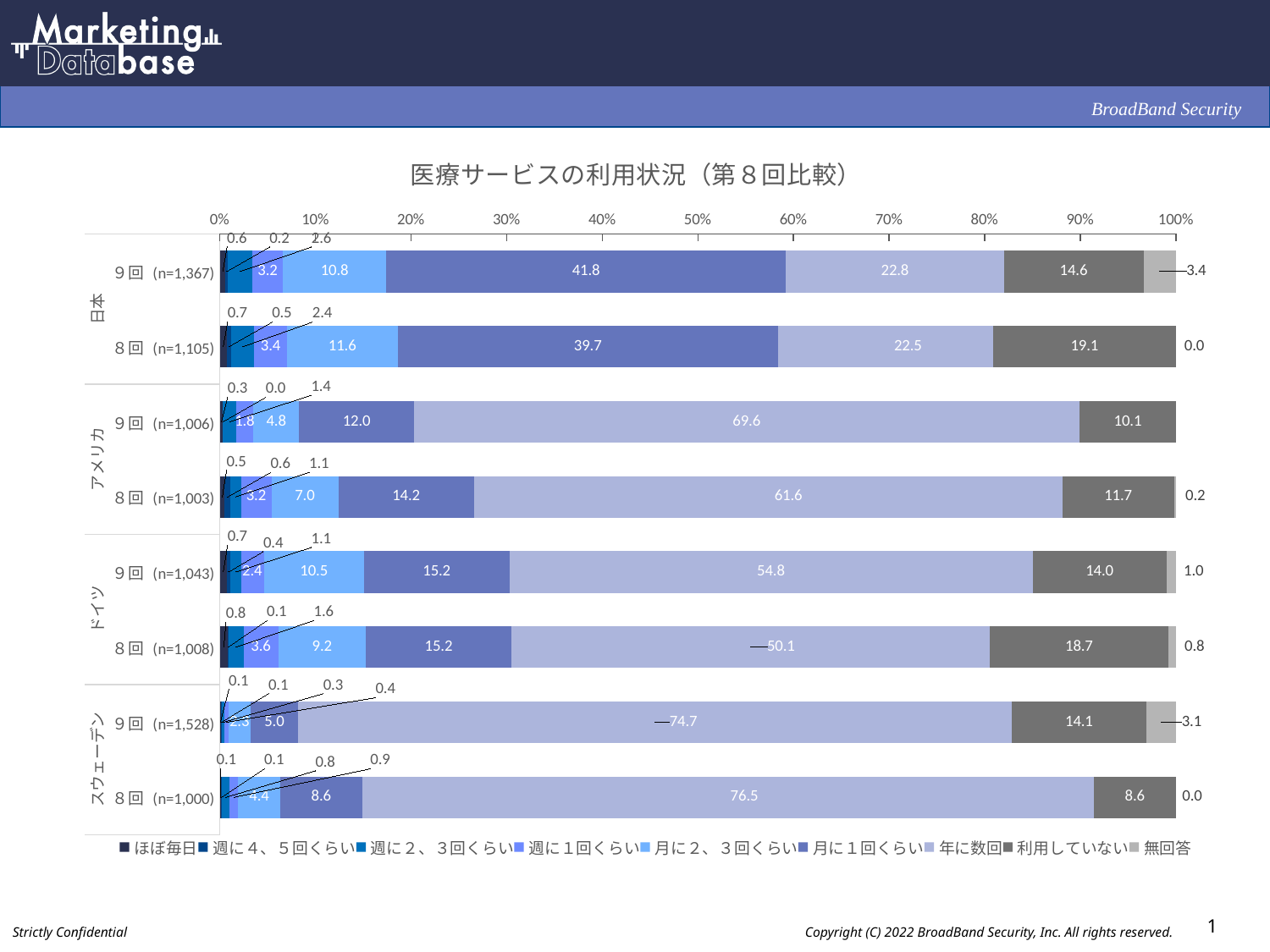
What is the value of 年に数回 for スウェーデン 8回 (n=1,000)? 76.5 What is the difference between the 年に数回 values for アメリカ 9回 (n=1,006) and アメリカ 8回 (n=1,003)? 8.0 How many series does the legend list? 9 Which is larger: the 利用していない value for 日本 9回 (n=1,367) or for 日本 8回 (n=1,105)? 日本 8回 (n=1,105) What is the value of 年に数回 for 日本 9回 (n=1,367)? 22.8 Which bar has the lowest value for 年に数回? 日本 8回 (n=1,105) What kind of chart is shown on the slide? stacked bar chart Which bar has the highest value for 年に数回? スウェーデン 8回 (n=1,000) What is the title of the chart? 医療サービスの利用状況（第８回比較） What is the value of 利用していない for ドイツ 8回 (n=1,008)? 18.7 What is the value of 月に１回くらい for 日本 8回 (n=1,105)? 39.7 How many bars (survey rows) are plotted in the chart? 8